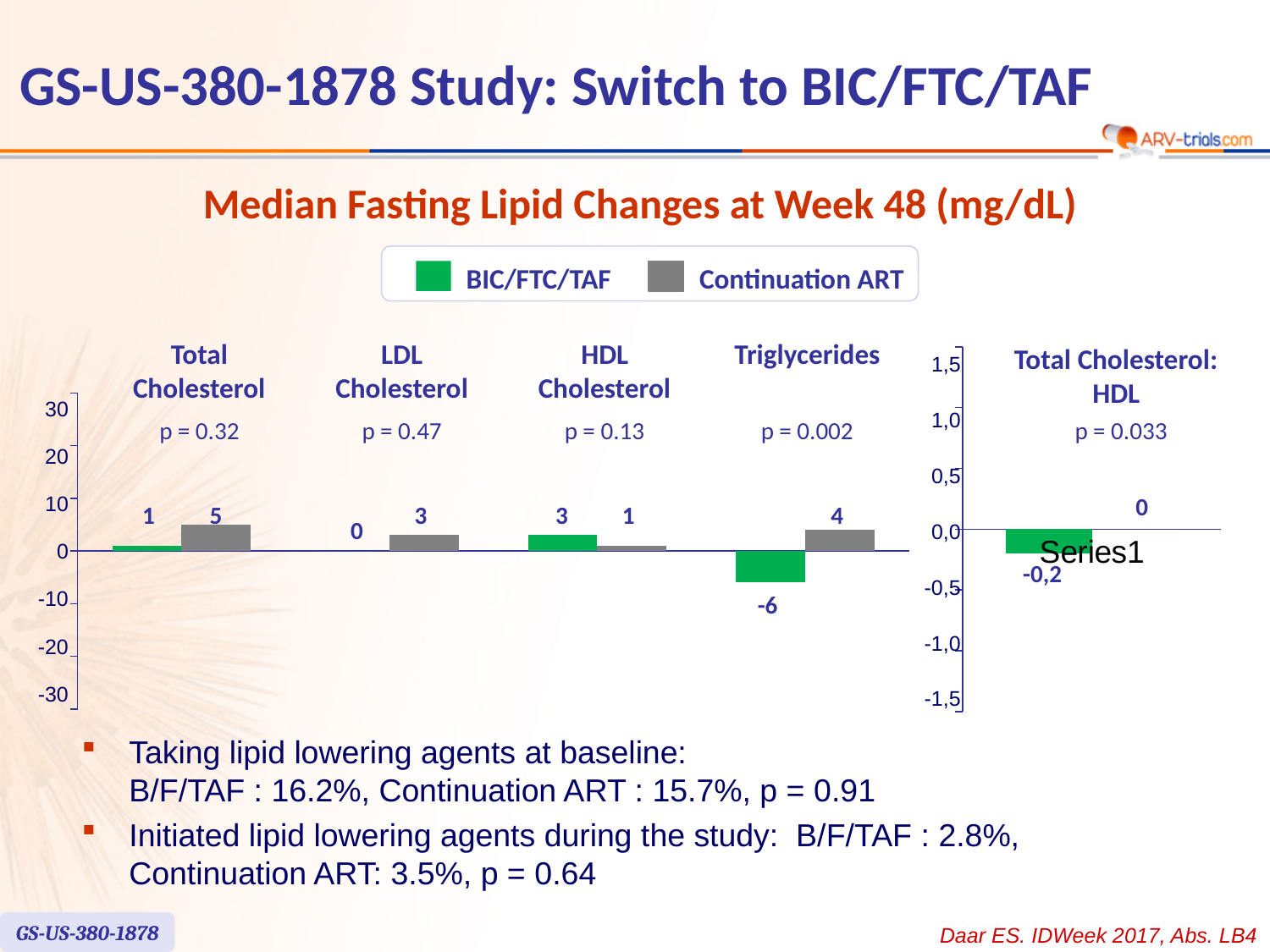
In the left chart, what is the difference between the Continuation ART and BIC/FTC/TAF values for Triglycerides? 10 In the left chart, which lipid category has the lowest value for BIC/FTC/TAF? Triglycerides In the left chart, what is the median change in Total Cholesterol for BIC/FTC/TAF? 1 How many series does the legend list? 2 In the Total Cholesterol: HDL chart, what is the value for BIC/FTC/TAF? -0,2 In the left chart, what is the median change in LDL Cholesterol for Continuation ART? 3 In the left chart, what is the median change in Triglycerides for BIC/FTC/TAF? -6 What type of chart is used to show the median fasting lipid changes? Bar chart In the left chart, which is larger for HDL Cholesterol: BIC/FTC/TAF or Continuation ART? BIC/FTC/TAF In the left chart, what is the median change in Total Cholesterol for Continuation ART? 5 In the left chart, what is the median change in HDL Cholesterol for BIC/FTC/TAF? 3 How many lipid categories are shown in the left chart? 4